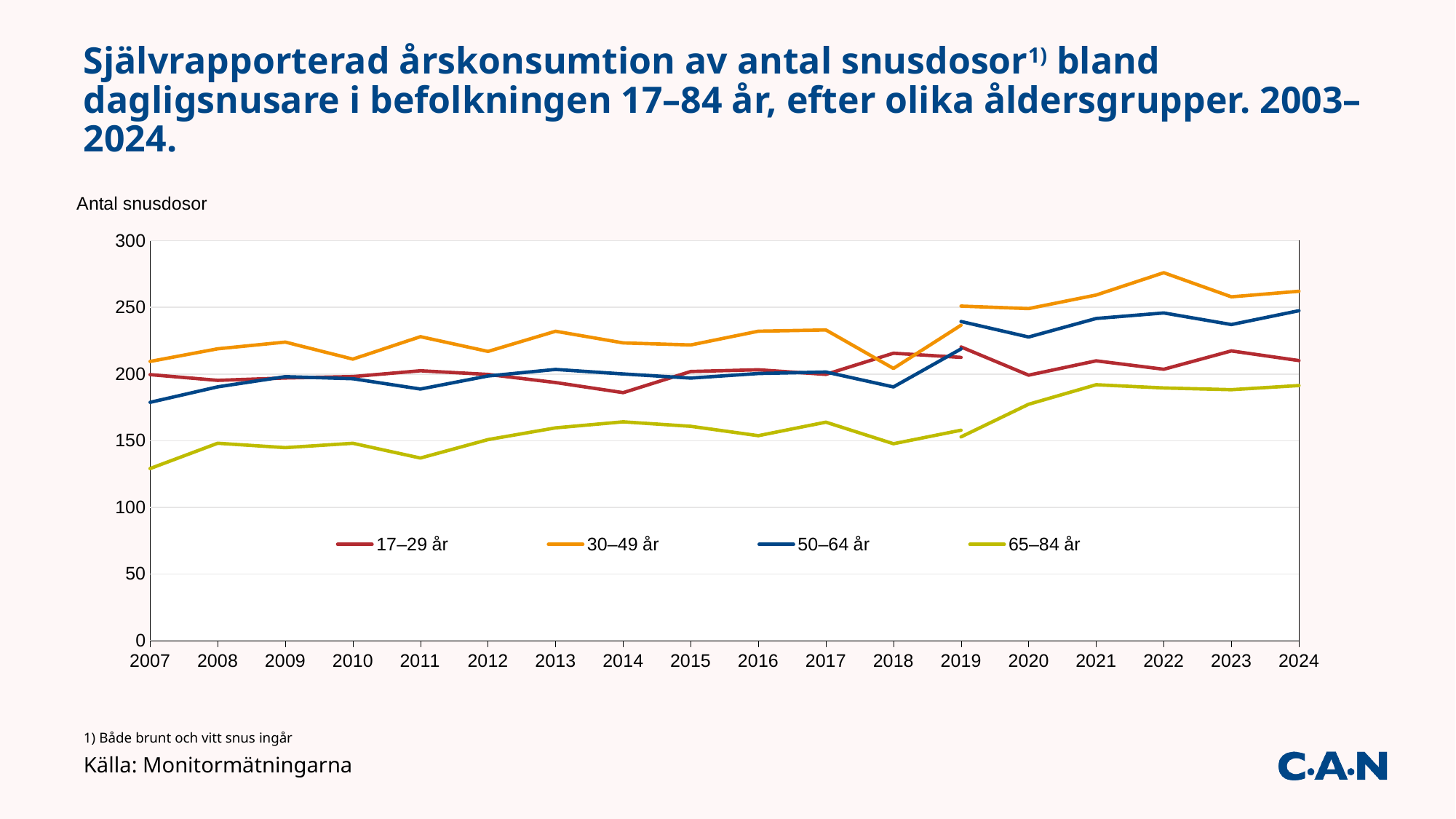
In 2007, which is larger: the value for 17–29 år or the value for 65–84 år? 17–29 år Which age group has the highest value in 2024? 30–49 år What is the label on the y axis of the chart? Antal snusdosor How many years are shown along the x axis? 18 What kind of chart is shown on the slide? line chart Is the value for 50–64 år in 2007 greater or less than 200? less Is the value for 65–84 år in 2024 greater or less than 200? less Is the value for 65–84 år in 2007 greater or less than 150? less How many series does the legend list? 4 Does the value for 65–84 år rise or fall overall from 2007 to 2024? rise Which age group has the lowest value in 2024? 65–84 år